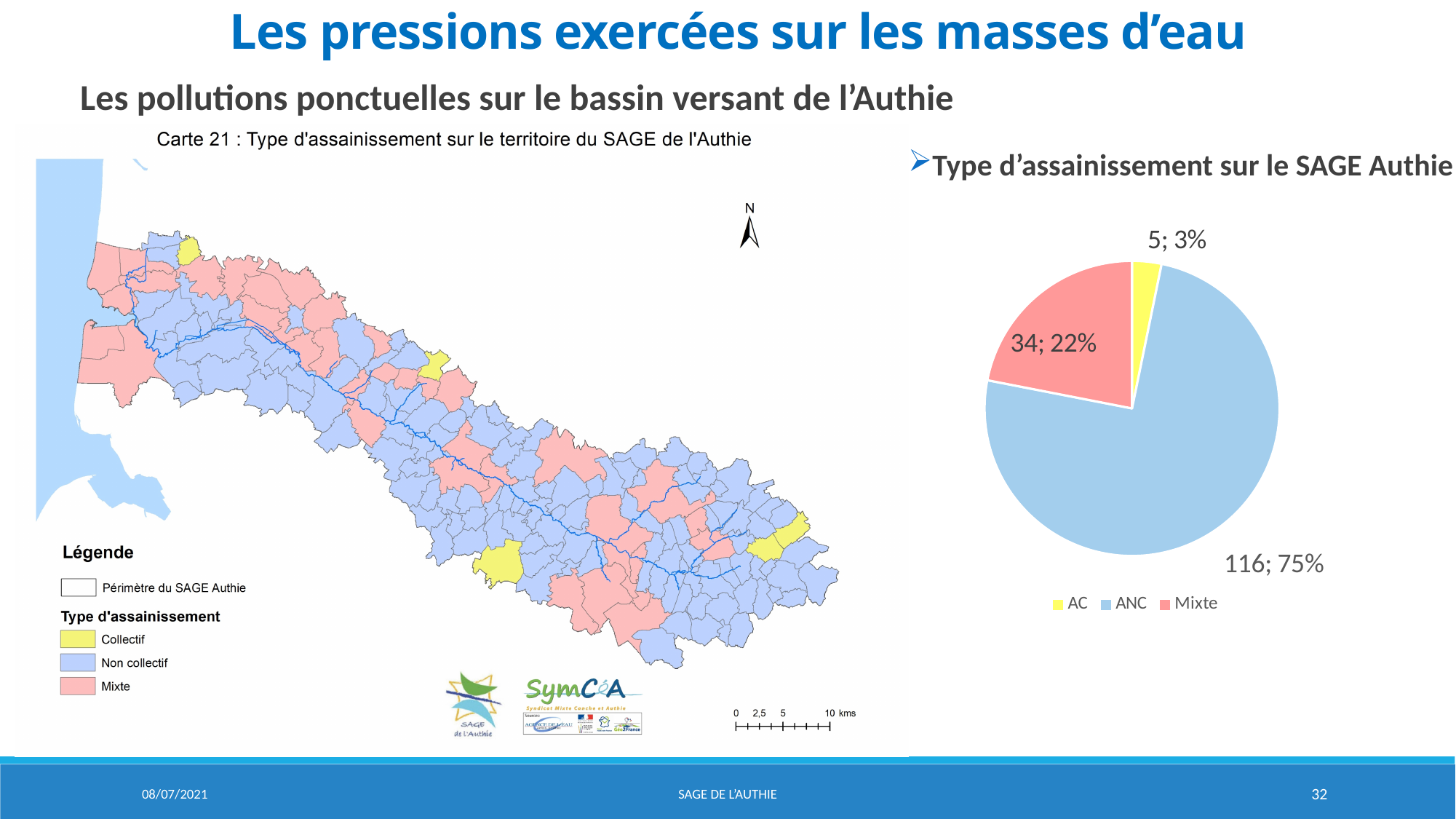
In the pie chart, what is the count for Mixte? 34 In the pie chart, what is the difference between the counts for ANC and Mixte? 82 In the pie chart, what share does AC represent? 3% What kind of chart is shown on the right of the slide? pie chart In the pie chart, what is the count for ANC? 116 Which category has the largest slice in the pie chart? ANC In the pie chart, what share does Mixte represent? 22% Which category has the smallest slice in the pie chart? AC In the pie chart, what share does ANC represent? 75% In the pie chart, which is larger, the count for Mixte or the count for AC? Mixte In the pie chart, what is the count for AC? 5 How many categories does the pie chart's legend list? 3